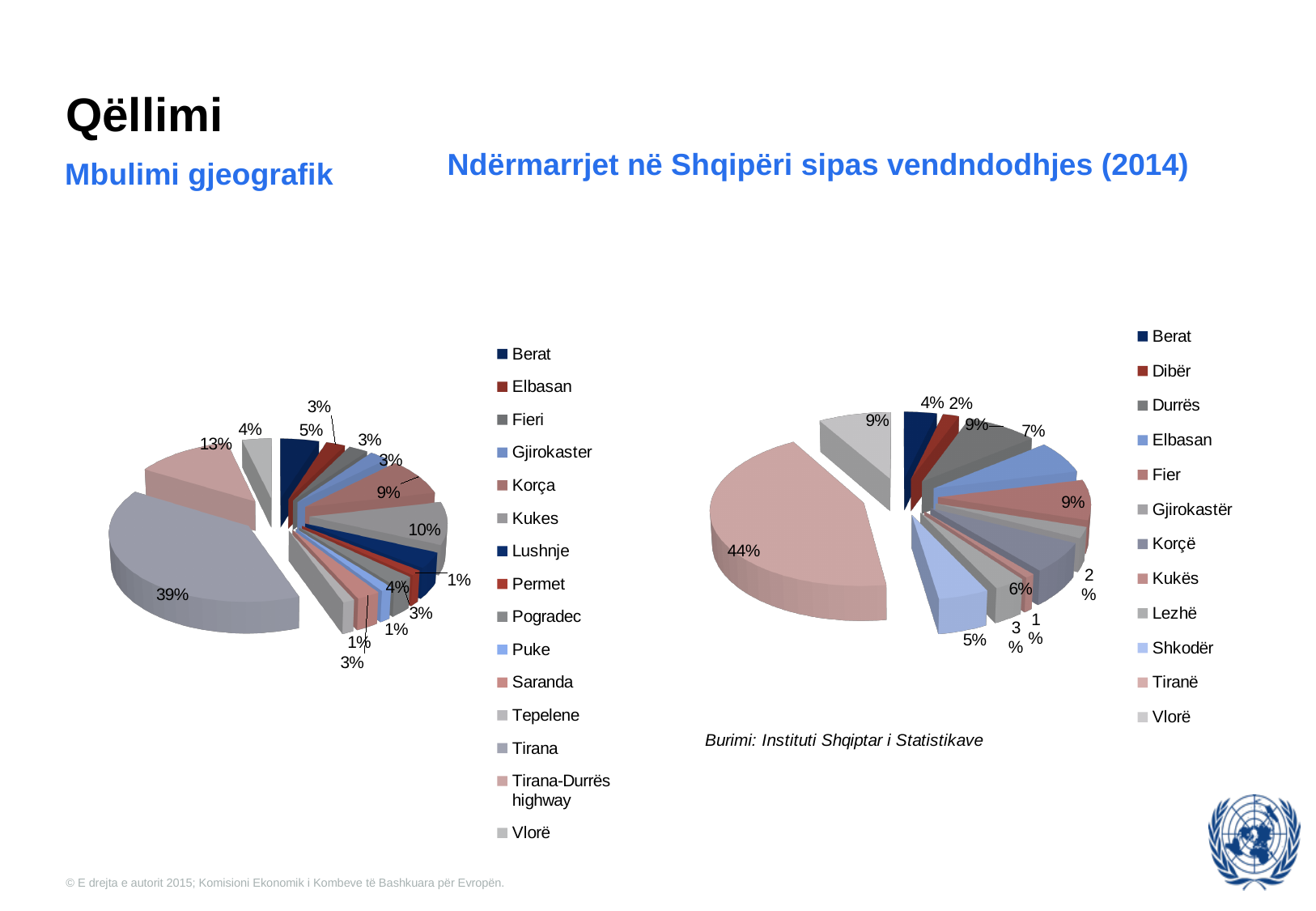
What is the difference in percentage points between Tiranë's share in the right pie chart (44%) and Tirana's share in the left pie chart (39%)? 5 percentage points How many categories does the legend of the left pie chart list? 15 In the right pie chart, what share does Tiranë have? 44% In the right pie chart, what share does Vlorë have? 9% How many categories does the legend of the right pie chart list? 12 In the left pie chart, which category has the largest share? Tirana What type of chart is shown on the left of the slide? pie chart In the right pie chart, which is larger: the share of Tiranë or the share of Vlorë? Tiranë What is the source cited below the right pie chart? Burimi: Instituti Shqiptar i Statistikave In the left pie chart, what share does Tirana have? 39% In the left pie chart, what share does Tirana-Durrës highway have? 13% In the right pie chart titled 'Ndërmarrjet në Shqipëri sipas vendndodhjes (2014)', which category has the largest share? Tiranë